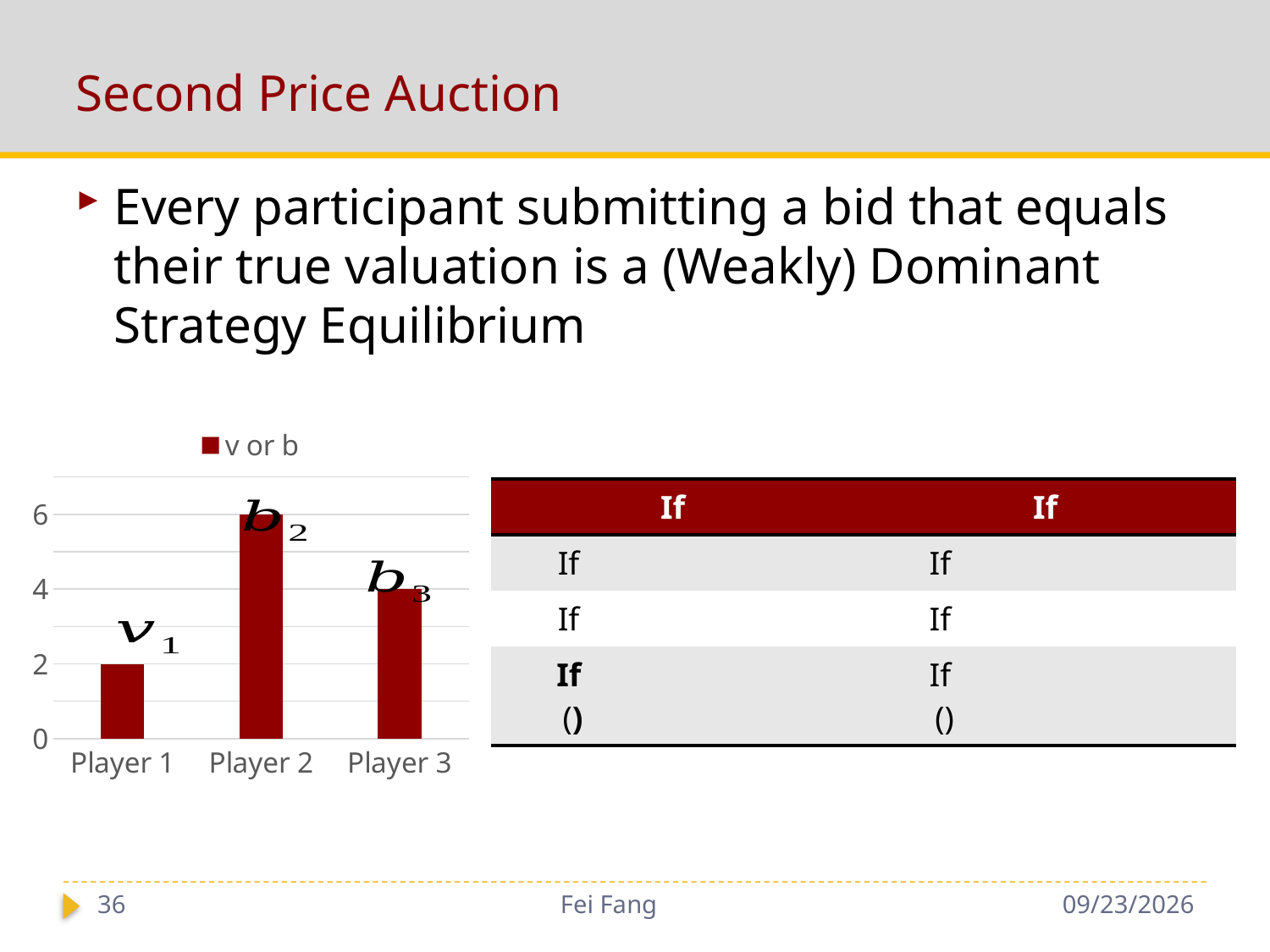
Which player has the lowest bar in the chart? Player 1 What kind of chart is shown on the slide? bar chart How many series does the chart legend list? 1 What is the value for Player 3 in the bar chart? 4 What is the value for Player 1 in the bar chart? 2 What is the difference between the values for Player 2 and Player 3? 2 Which is larger, the value for Player 3 or the value for Player 1? Player 3 How many players (categories) are shown on the x axis of the chart? 3 What is the value for Player 2 in the bar chart? 6 Which player has the highest bar in the chart? Player 2 What is the difference between the values for Player 2 and Player 1? 4 What is the legend entry of the chart? v or b